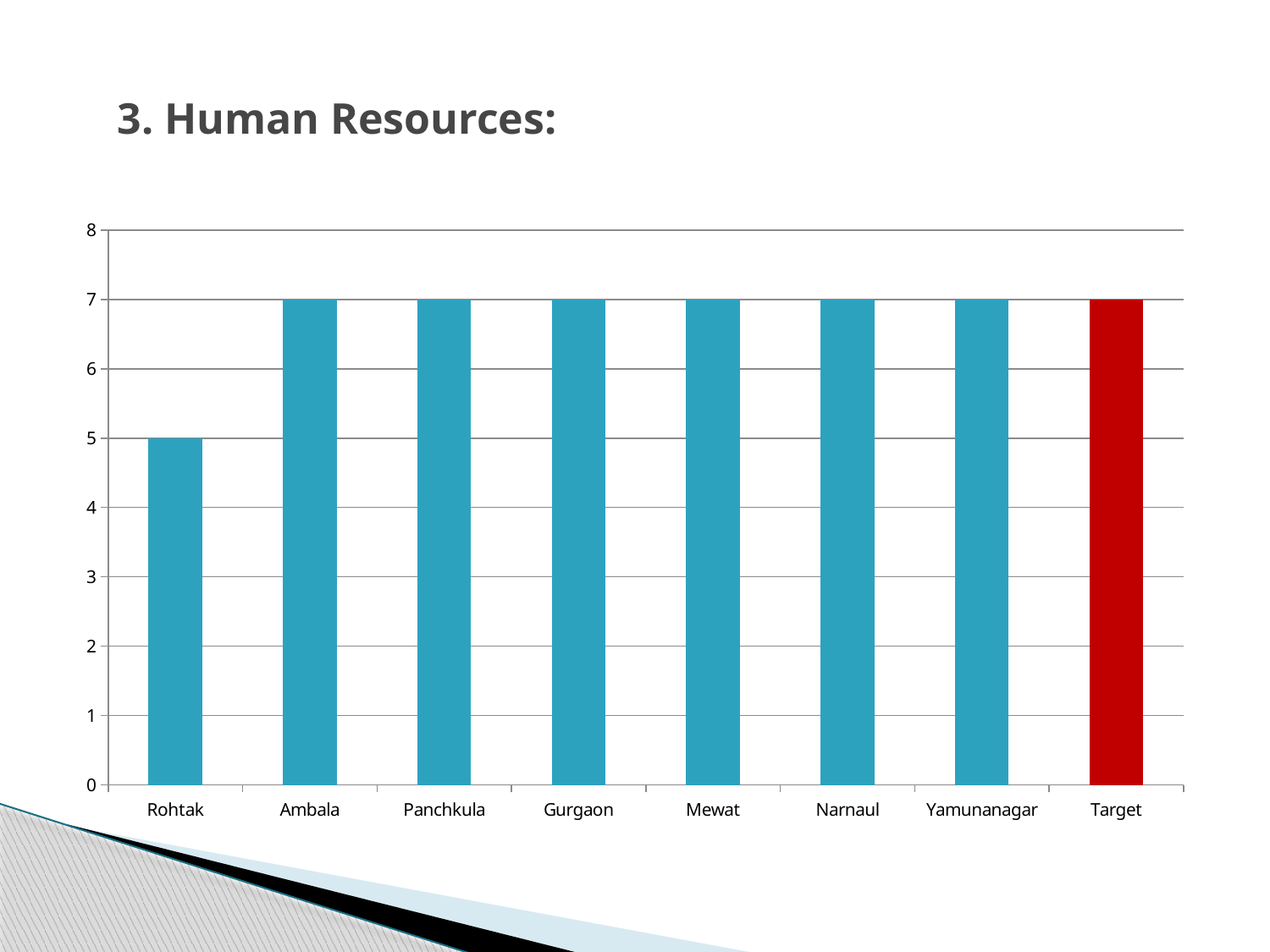
Which category has the lowest value? Rohtak What is the value for Target? 7 What is the difference between the Target value and the Rohtak value? 2 Is the value for Mewat greater or less than 6? greater Is the value for Rohtak greater or less than 6? less What is the value for Yamunanagar? 7 What kind of chart is shown on the slide? bar chart Which is larger, the value for Rohtak or the value for Gurgaon? Gurgaon Which bar is coloured red rather than blue? Target How many categories are shown on the x axis? 8 What is the value for Rohtak? 5 What is the value for Ambala? 7